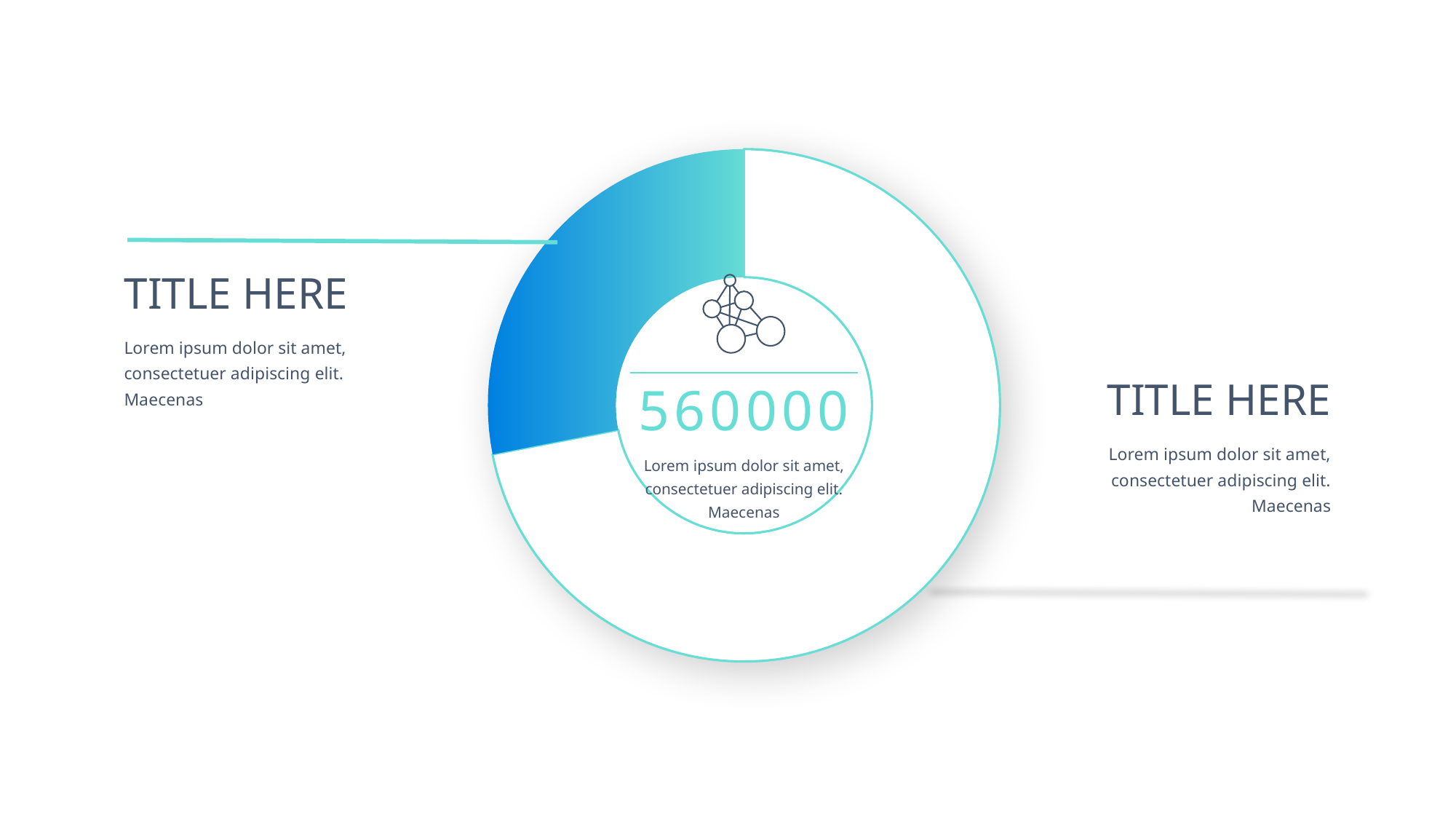
Which slice of the pie chart is the smallest? the blue slice What kind of chart is shown on the slide? doughnut chart What number is printed in the centre of the pie chart? 560000 Which slice of the pie chart is larger, the blue one or the white one? the white one How many slices does the pie chart have? 2 What colour is the smaller slice of the pie chart? blue Does the blue slice cover more or less than half of the pie chart? less